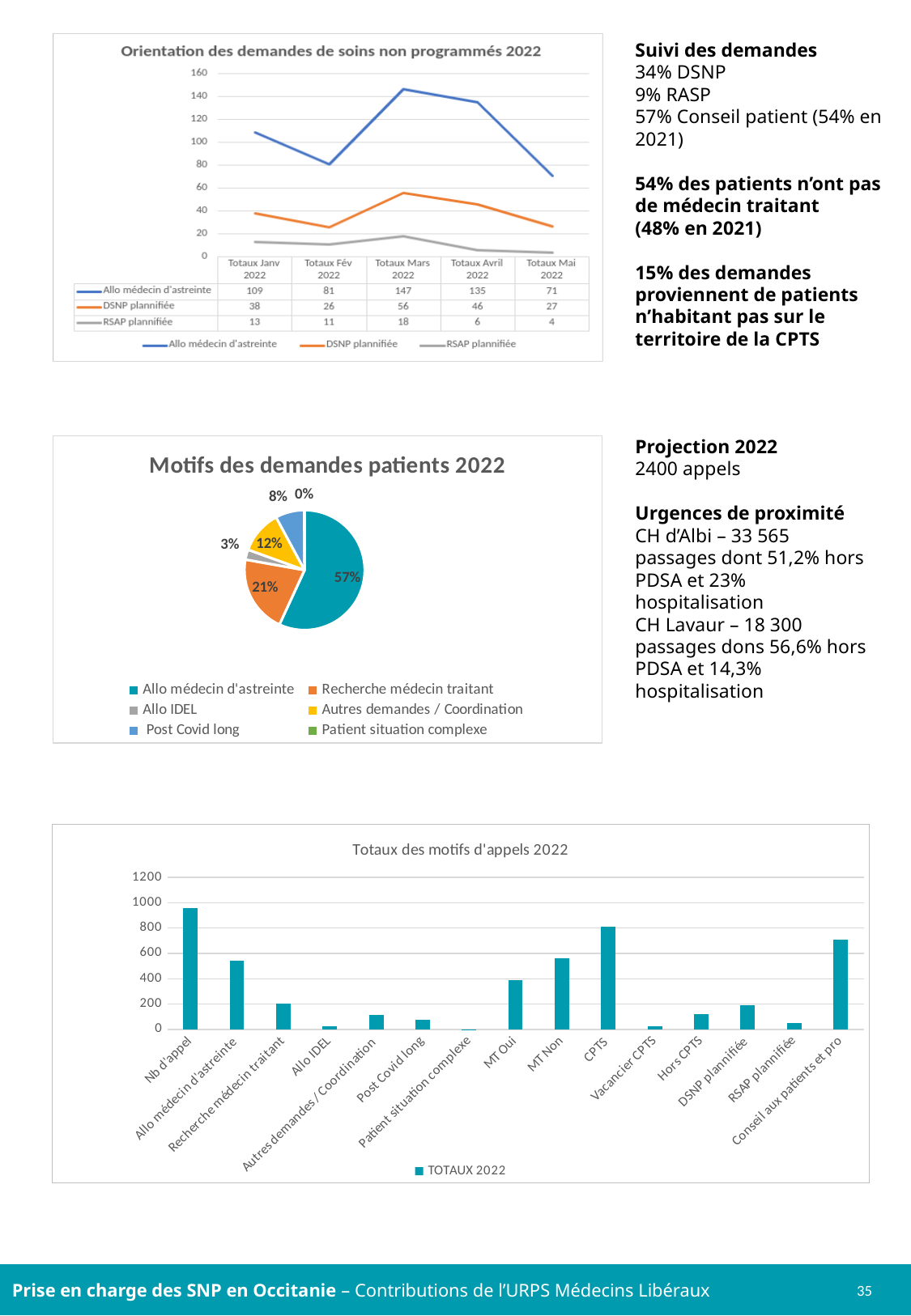
In the chart 'Orientation des demandes de soins non programmés 2022', what is the value for Allo médecin d'astreinte in Totaux Mars 2022? 147 How many categories are shown on the x axis of the bar chart 'Totaux des motifs d'appels 2022'? 15 In the chart 'Orientation des demandes de soins non programmés 2022', what is the value for DSNP plannifiée in Totaux Fév 2022? 26 In the pie chart 'Motifs des demandes patients 2022', which is larger: Recherche médecin traitant or Autres demandes / Coordination? Recherche médecin traitant In the pie chart 'Motifs des demandes patients 2022', what share does Allo médecin d'astreinte have? 57% In the chart 'Orientation des demandes de soins non programmés 2022', what is the difference between Allo médecin d'astreinte in Totaux Mars 2022 and Totaux Mai 2022? 76 What kind of chart is 'Orientation des demandes de soins non programmés 2022'? Line chart In the bar chart 'Totaux des motifs d'appels 2022', is the value for MT Non greater or less than 400? greater In the bar chart 'Totaux des motifs d'appels 2022', which category has the highest value? Nb d'appel In the chart 'Orientation des demandes de soins non programmés 2022', which month has the highest value for RSAP plannifiée? Totaux Mars 2022 How many series does the legend of the chart 'Orientation des demandes de soins non programmés 2022' list? 3 In the pie chart 'Motifs des demandes patients 2022', which category has the smallest share? Patient situation complexe